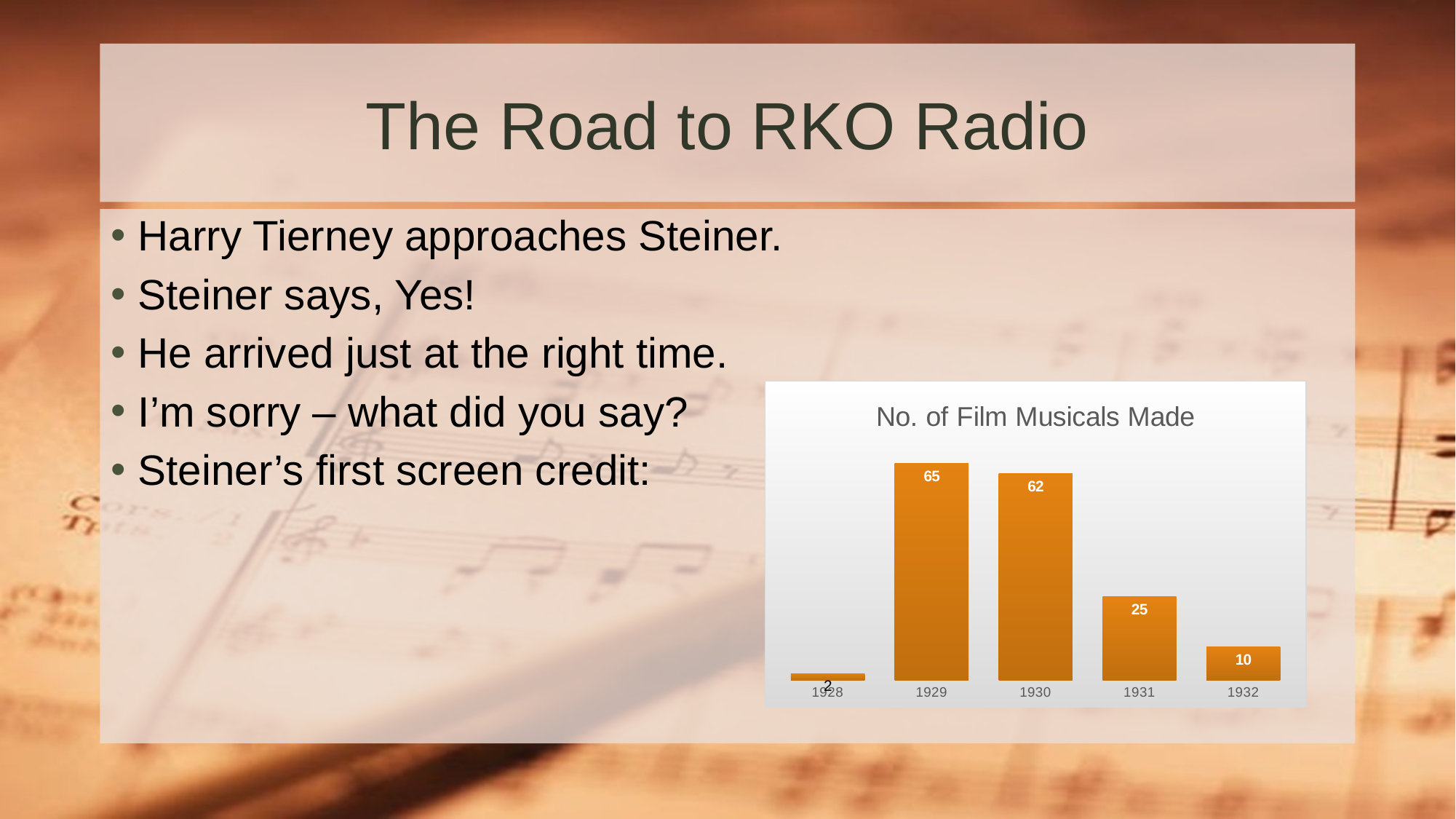
What is the title of the chart? No. of Film Musicals Made Which is larger, the value for 1931 or the value for 1932? 1931 Which year has the lowest number of film musicals made? 1928 How many film musicals were made in 1929? 65 How many years are shown on the x axis? 5 Which year has the highest number of film musicals made? 1929 What is the value for 1931? 25 What is the value for 1928? 2 Do the values rise or fall from 1929 to 1932? fall What is the value for 1932? 10 What is the difference between the values for 1929 and 1930? 3 What type of chart is shown on the slide? bar chart